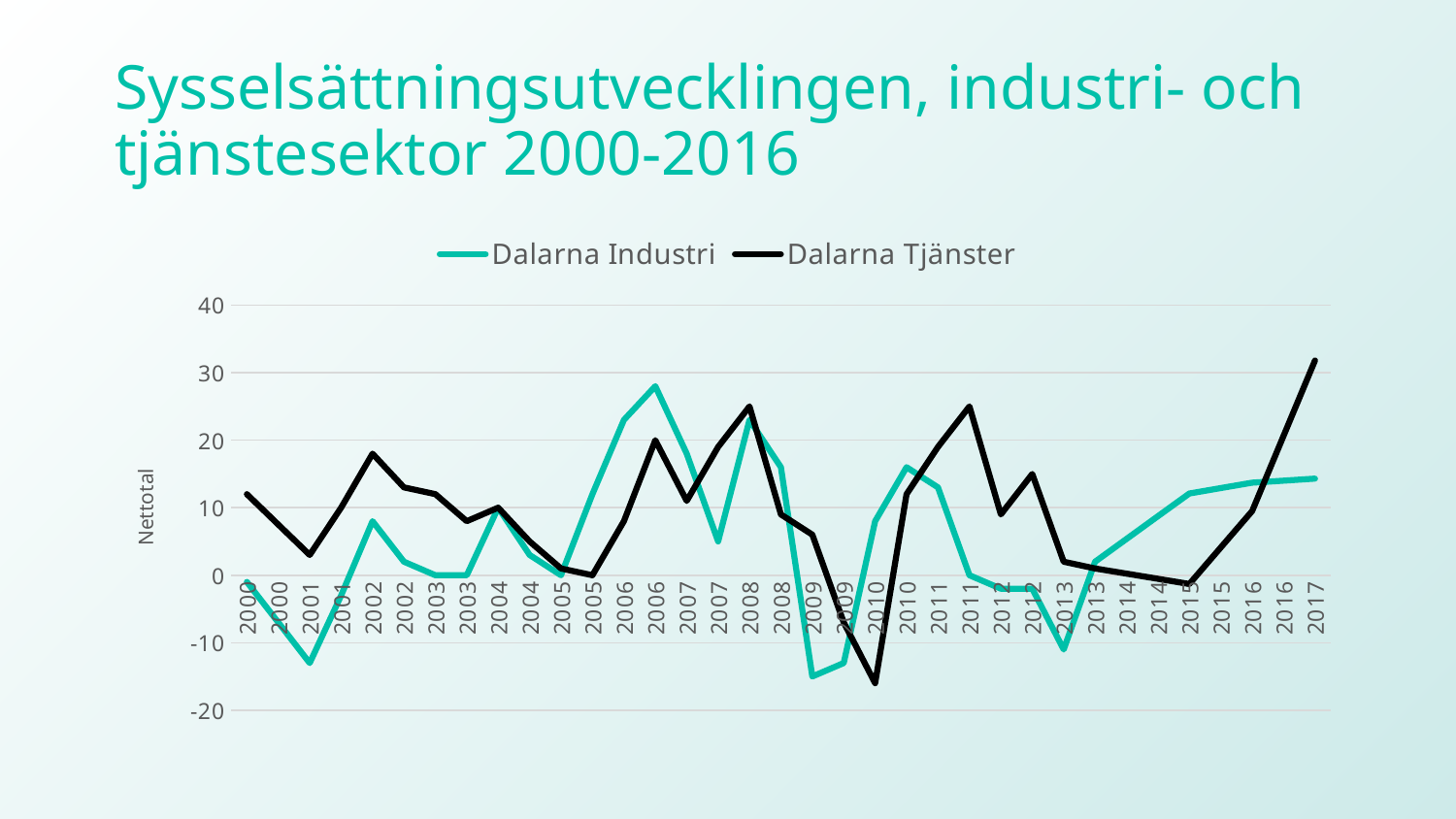
Is the value for Dalarna Industri at the first 2009 point greater or less than -10? less Is the value for Dalarna Industri at the first 2001 point greater or less than 0? less Is the value for Dalarna Tjänster at 2017 greater or less than 20? greater At 2017, which series has the higher value, Dalarna Industri or Dalarna Tjänster? Dalarna Tjänster How many series does the legend list? 2 At the first 2001 point, which series has the higher value, Dalarna Industri or Dalarna Tjänster? Dalarna Tjänster Does the Dalarna Tjänster line rise or fall from 2015 to 2017? rise What is the label on the vertical axis? Nettotal What kind of chart is shown on the slide? line chart Which series is drawn in black? Dalarna Tjänster